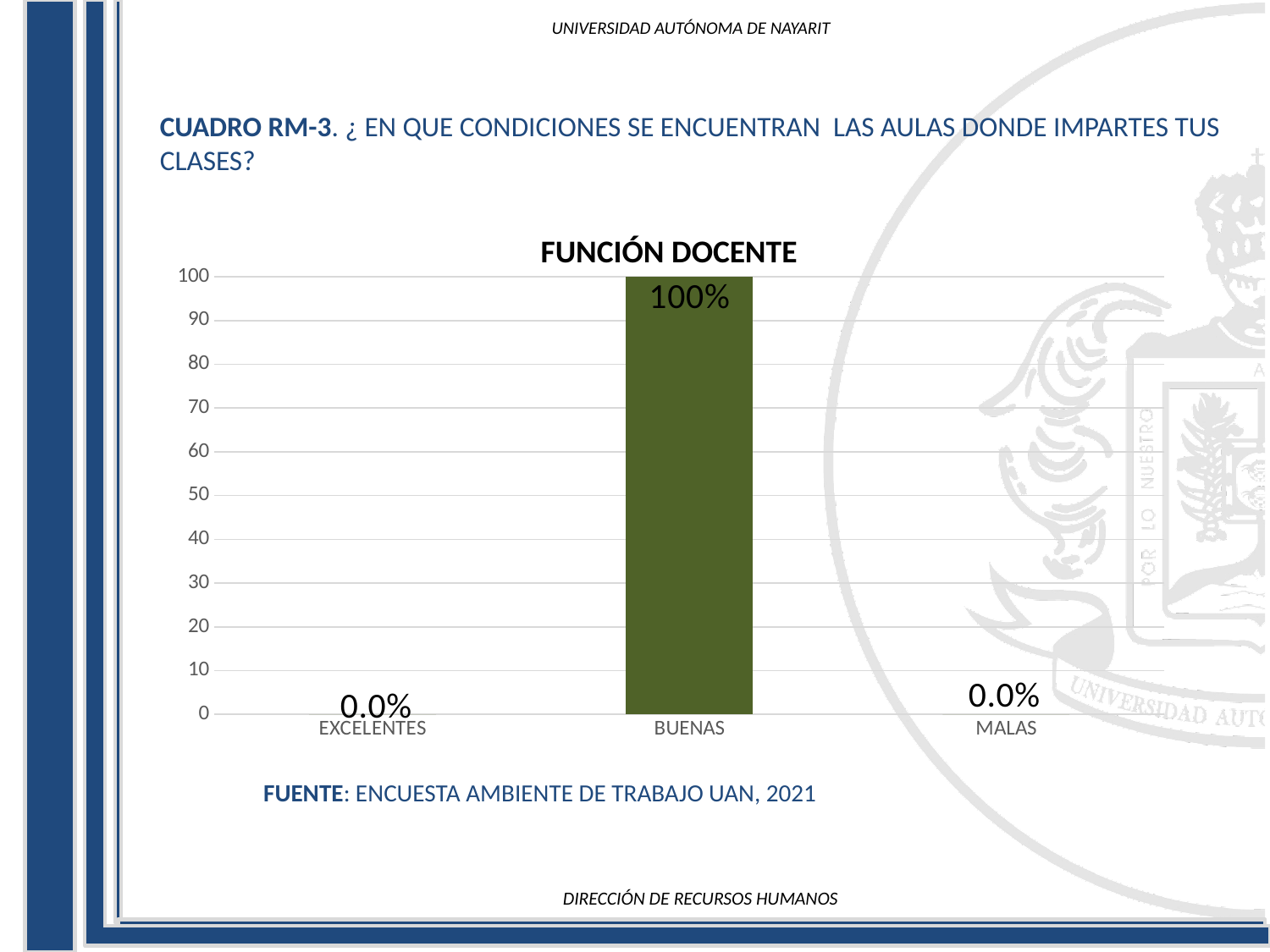
What is the title of the chart? FUNCIÓN DOCENTE Which is larger, the value for BUENAS or the value for EXCELENTES? BUENAS What is the value for MALAS? 0.0% What is the value for EXCELENTES? 0.0% Which category has the highest value? BUENAS What is the value for BUENAS? 100% How many categories are shown on the x axis? 3 What is the highest value shown on the vertical axis? 100 What is the difference between the values for BUENAS and MALAS? 100% Is the value for BUENAS greater or less than 50? greater What kind of chart is shown on the slide? bar chart